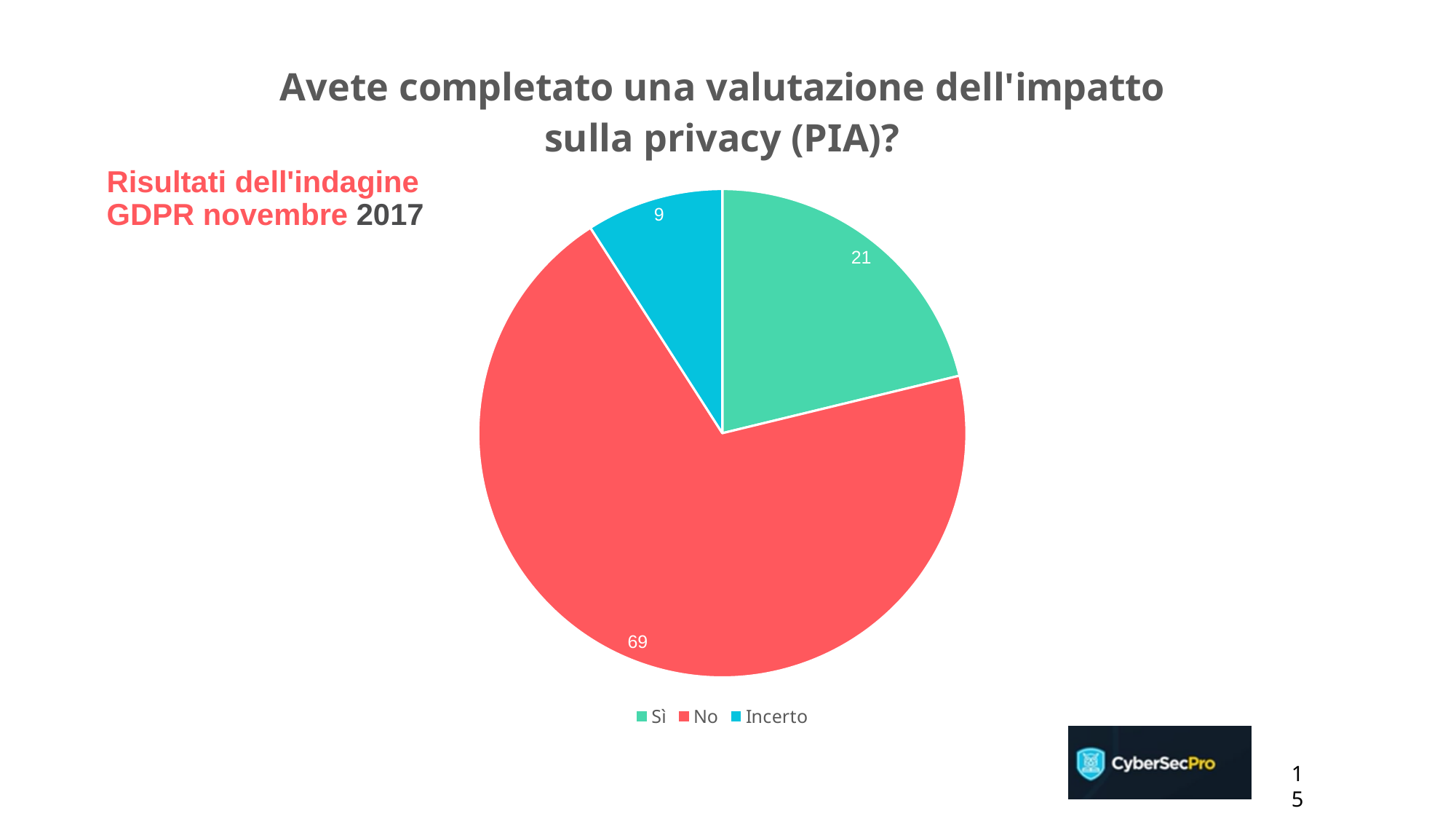
What is the difference between the values for "No" and "Sì"? 48 How many slices does the pie chart have? 3 What is the difference between the values for "Sì" and "Incerto"? 12 What value is shown for the "Incerto" slice of the pie chart? 9 What kind of chart is shown on the slide? Pie chart Which is larger, the value for "Sì" or the value for "Incerto"? Sì Which category has the largest slice in the pie chart? No What value is shown for the "Sì" slice of the pie chart? 21 What is the total of all the values shown in the pie chart? 99 What value is shown for the "No" slice of the pie chart? 69 What colour is the "No" slice in the pie chart? Red Which category has the smallest slice in the pie chart? Incerto